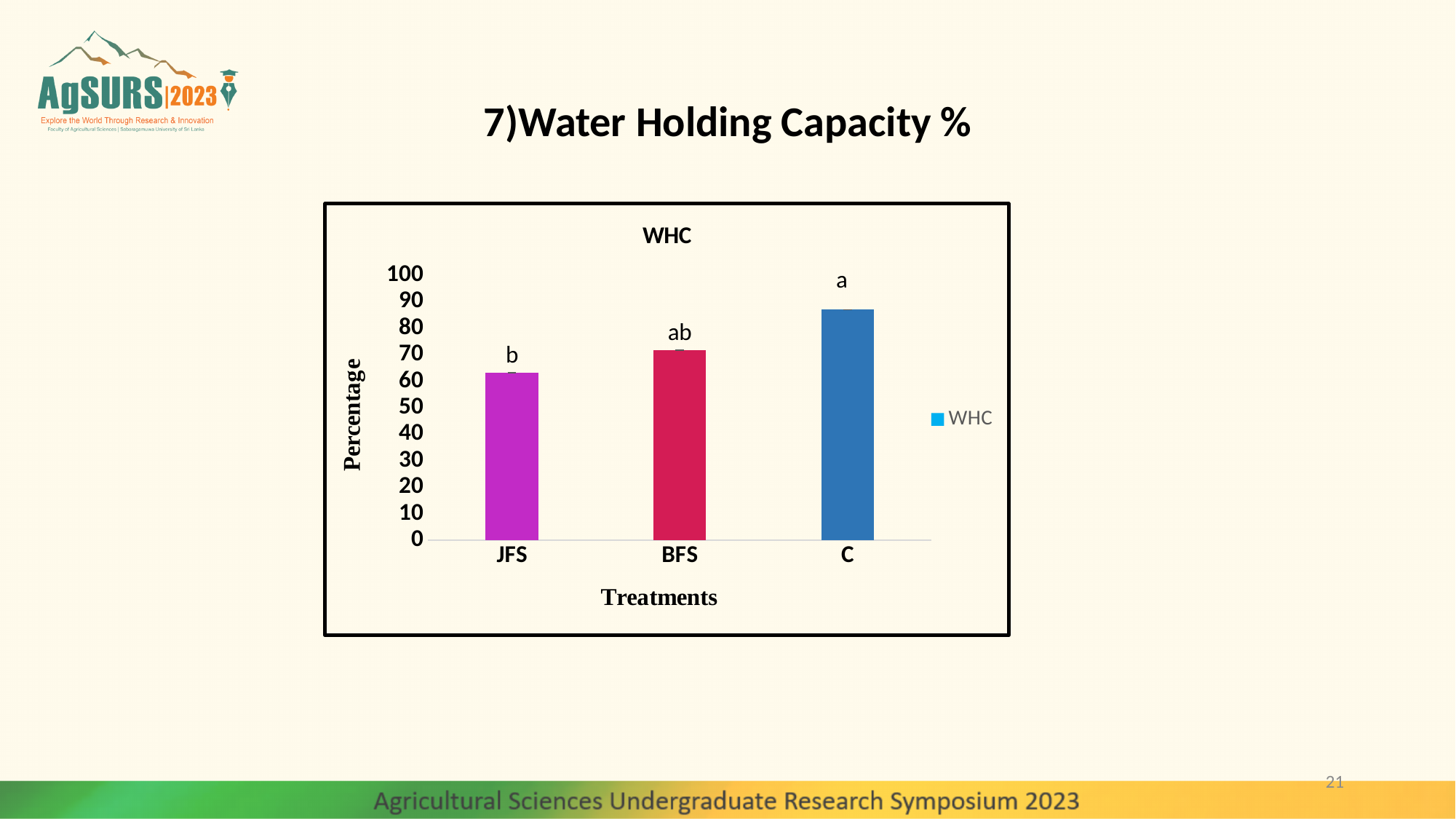
Do the values rise or fall moving from JFS to C along the x axis? rise What kind of chart is shown on the slide? bar chart Which has a larger value in the WHC chart, BFS or JFS? BFS Is the value for JFS greater or less than 70? less Which treatment has the lowest water holding capacity in the WHC chart? JFS Which treatment has the highest water holding capacity in the WHC chart? C How many treatments are plotted on the x axis of the WHC chart? 3 Is the value for C greater or less than 80? greater How many series does the legend of the WHC chart list? 1 Which has a larger value in the WHC chart, C or BFS? C What is the title of the x axis in the WHC chart? Treatments Is the value for BFS greater or less than 80? less